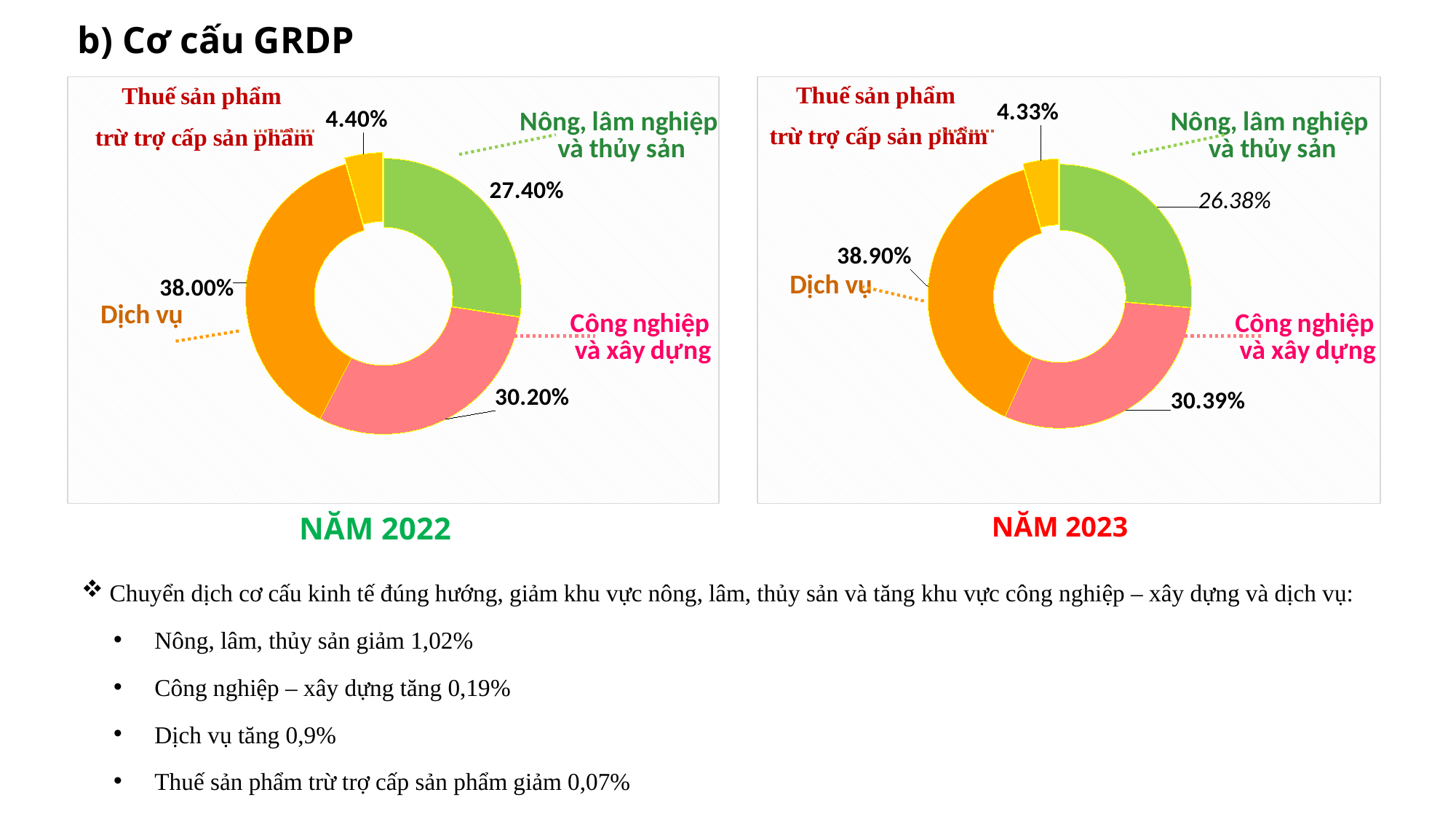
In the NĂM 2023 chart, what is the difference between Dịch vụ and Công nghiệp và xây dựng? 8.51% How many charts are on the slide? 2 In the NĂM 2022 chart, what is the value for Công nghiệp và xây dựng? 30.20% What kind of chart is the NĂM 2023 chart? Doughnut chart In the NĂM 2022 chart, which category has the largest share? Dịch vụ In the NĂM 2022 chart, what is the value for Dịch vụ? 38.00% In the NĂM 2023 chart, what is the value for Nông, lâm nghiệp và thủy sản? 26.38% In the NĂM 2022 chart, what colour is the Dịch vụ slice? Orange In the NĂM 2023 chart, what is the value for Thuế sản phẩm trừ trợ cấp sản phẩm? 4.33% In the NĂM 2022 chart, which is larger: Nông, lâm nghiệp và thủy sản or Công nghiệp và xây dựng? Công nghiệp và xây dựng How many categories does the NĂM 2022 chart show? 4 In the NĂM 2023 chart, which category has the smallest share? Thuế sản phẩm trừ trợ cấp sản phẩm